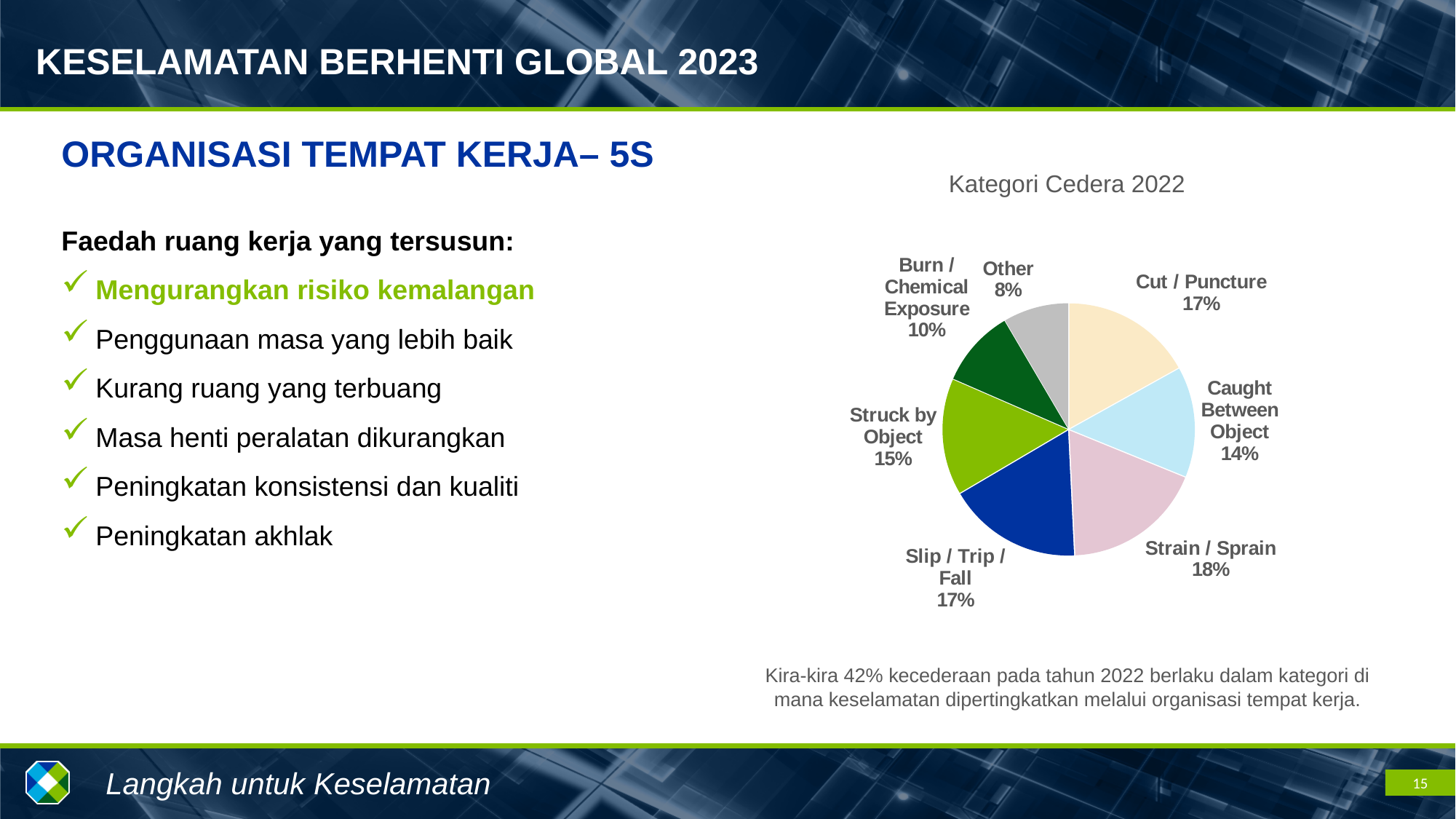
What percentage is shown for Slip / Trip / Fall? 17% What is the title of the chart on the slide? Kategori Cedera 2022 What is the combined share of Cut / Puncture and Slip / Trip / Fall? 34% How many categories are shown in the pie chart? 7 What kind of chart is shown under the title "Kategori Cedera 2022"? pie chart What is the difference between the Strain / Sprain share and the Other share? 10% Which injury category has the largest slice of the pie? Strain / Sprain What is the value shown for Caught Between Object? 14% Which is larger, the share for Struck by Object or the share for Caught Between Object? Struck by Object What percentage of injuries is attributed to Strain / Sprain? 18% Which injury category has the smallest slice of the pie? Other What share of the pie does Burn / Chemical Exposure represent? 10%